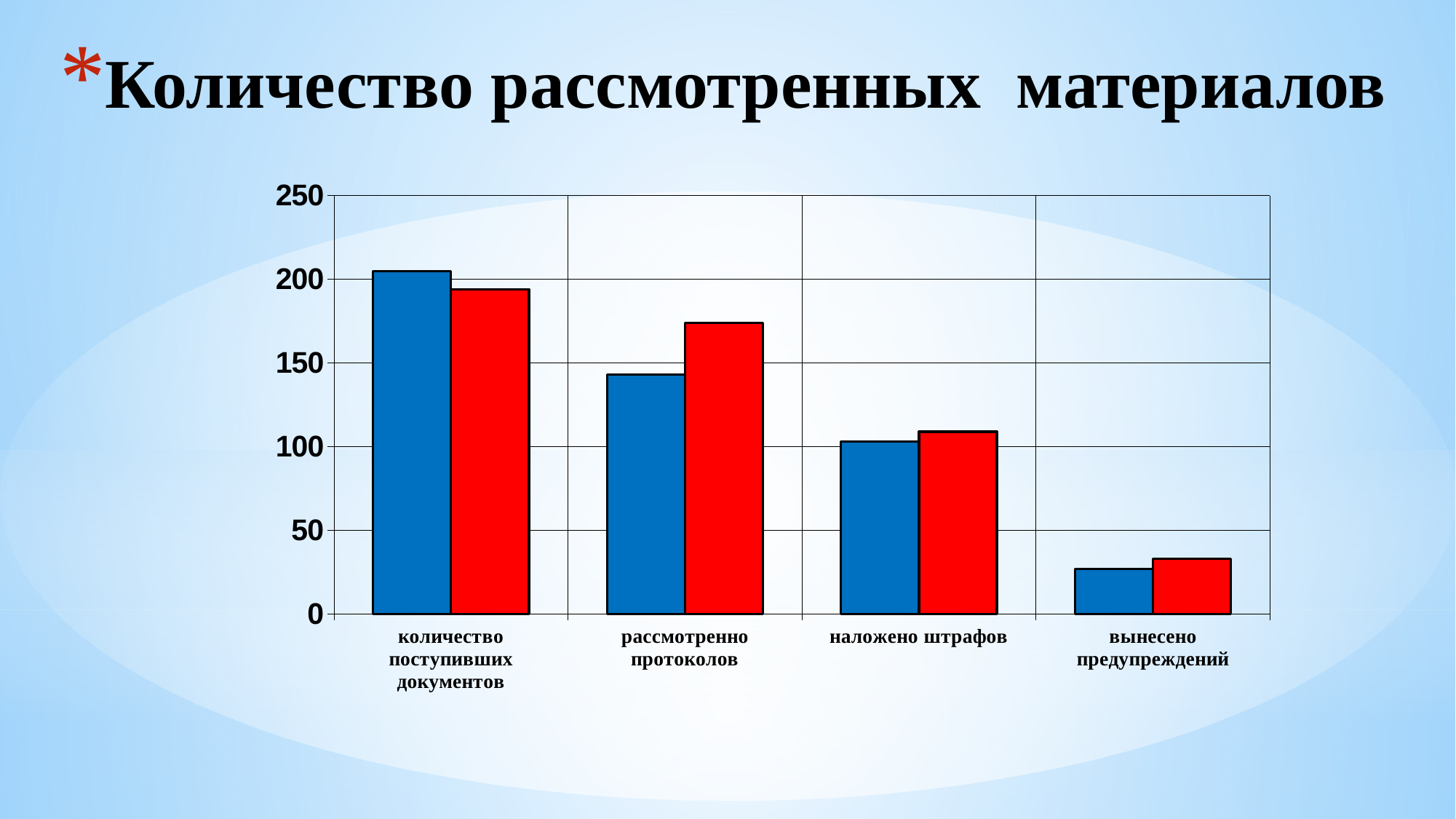
Which category has the tallest blue bar? количество поступивших документов What is the title of the slide containing the chart? Количество рассмотренных материалов For 'рассмотренно протоколов', which bar is taller, the blue one or the red one? red Is the blue bar for 'наложено штрафов' greater or less than 150? less How many bars are shown for each category in the chart? 2 Which category has the shortest red bar? вынесено предупреждений Do the bar heights generally rise or fall from left to right across the categories? fall Is the red bar for 'вынесено предупреждений' greater or less than 50? less What kind of chart is shown on the slide? bar chart Is the red bar for 'рассмотренно протоколов' greater or less than 150? greater How many categories are shown on the x axis of the chart? 4